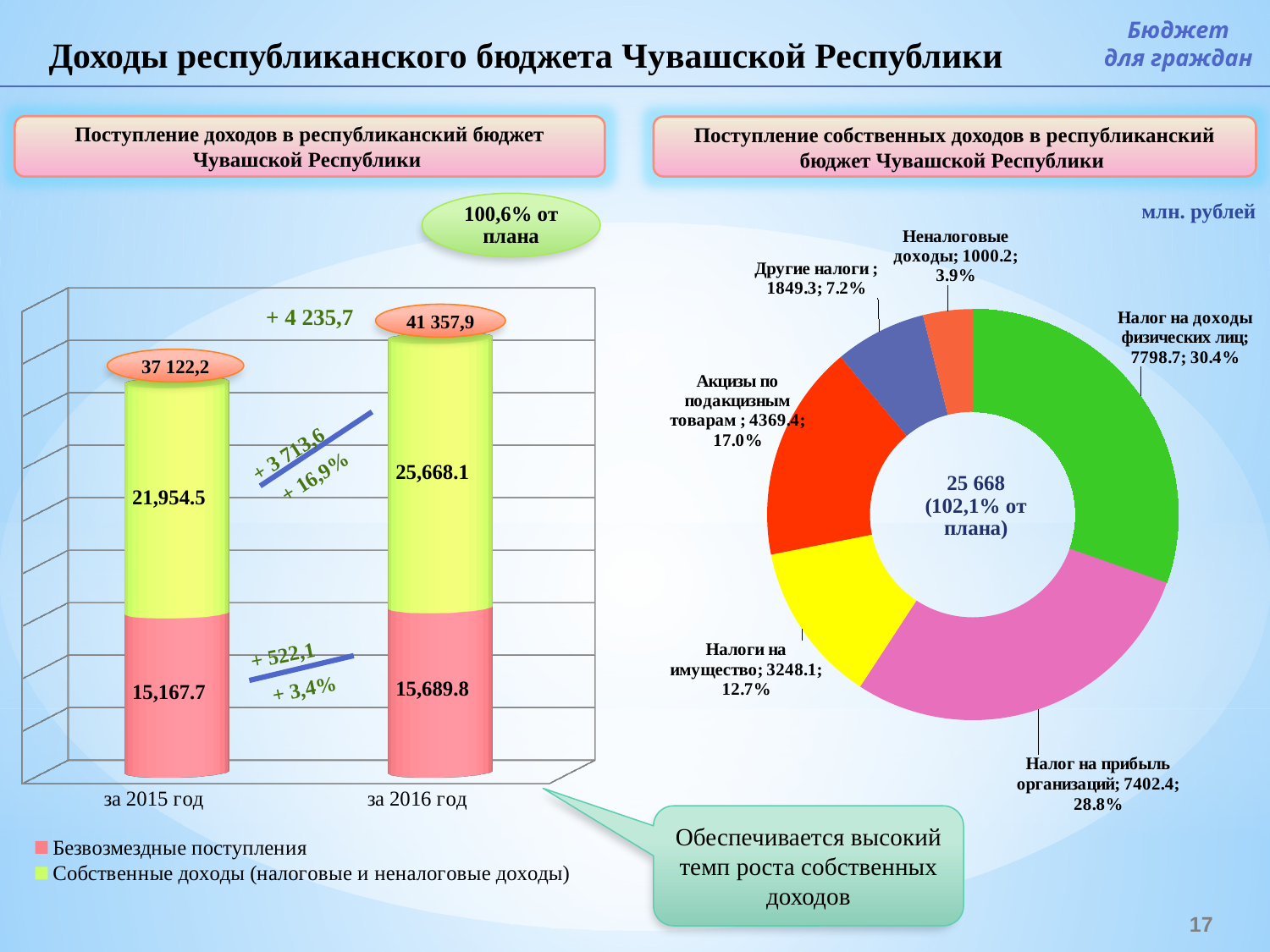
In the left chart, what is the total of the stacked bar for за 2015 год? 37 122,2 In the left chart, how many series does the legend list? 2 In the left chart, what is the value of Безвозмездные поступления for за 2015 год? 15,167.7 In the right chart, how many categories are shown? 6 In the left chart, what is the total of the stacked bar for за 2016 год? 41 357,9 In the right chart, which category has the smallest share? Неналоговые доходы In the right chart, what is the value for Акцизы по подакцизным товарам? 4369.4 In the right chart (Поступление собственных доходов в республиканский бюджет Чувашской Республики), which category has the largest share? Налог на доходы физических лиц In the right chart, what percentage share does Налог на прибыль организаций have? 28.8% In the left chart (Поступление доходов в республиканский бюджет Чувашской Республики), what is the value of Собственные доходы for за 2016 год? 25,668.1 In the left chart, what kind of chart is shown? Stacked bar chart In the left chart, which year has the larger value for Собственные доходы, за 2015 год or за 2016 год? за 2016 год